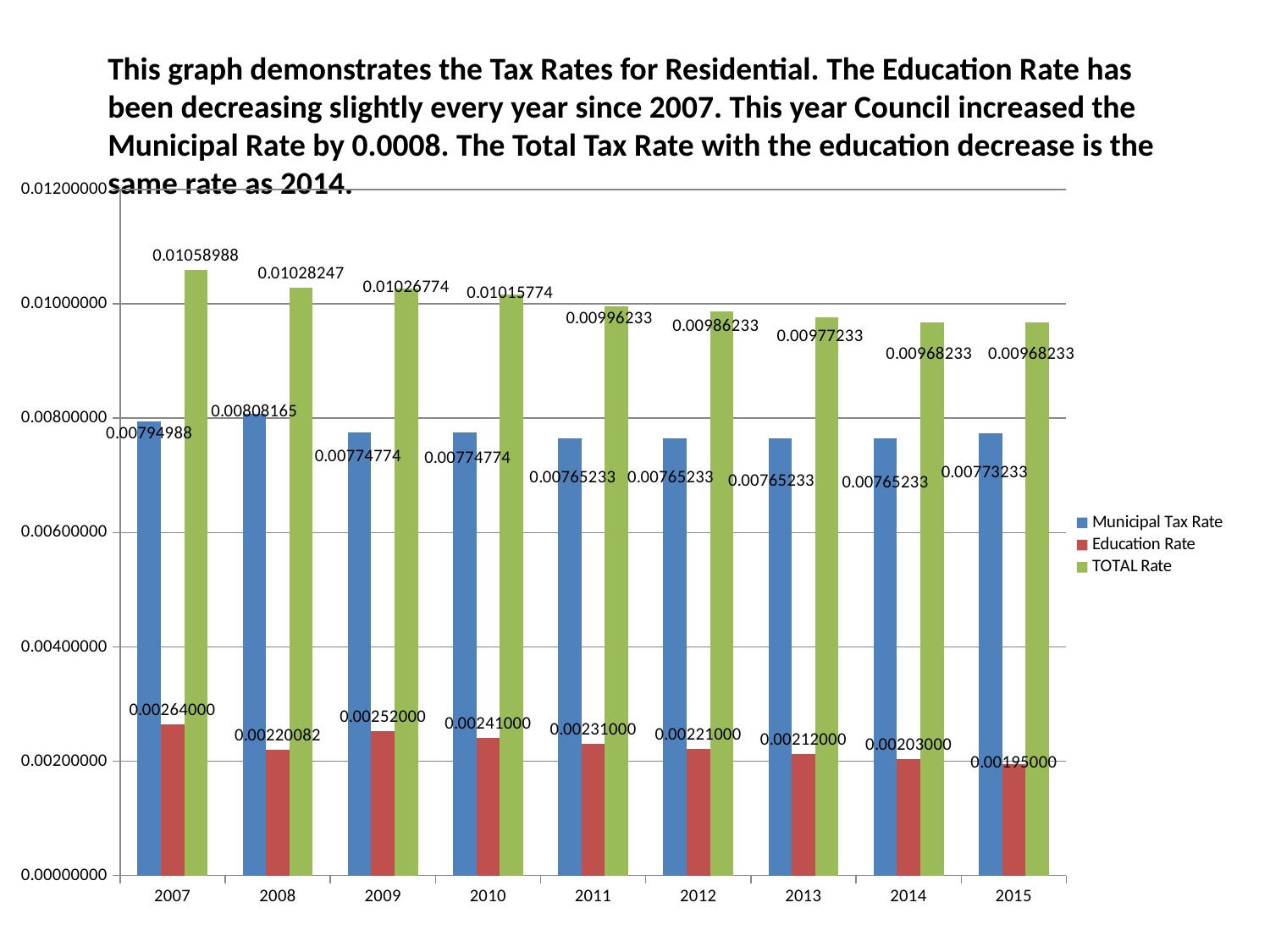
Which year has the lowest Education Rate? 2015 Does the Education Rate rise or fall from 2009 to 2015? fall What is the TOTAL Rate for 2007? 0.01058988 Which year has the highest TOTAL Rate? 2007 What is the Education Rate for 2010? 0.00241000 Is the TOTAL Rate for 2011 greater or less than 0.01000000? less How many years are shown on the x axis? 9 What is the difference between the Education Rate in 2007 and in 2015? 0.00069000 What is the Municipal Tax Rate for 2015? 0.00773233 How many series does the legend list? 3 Which is larger, the Municipal Tax Rate in 2008 or in 2009? 2008 What kind of chart is shown on the slide? bar chart